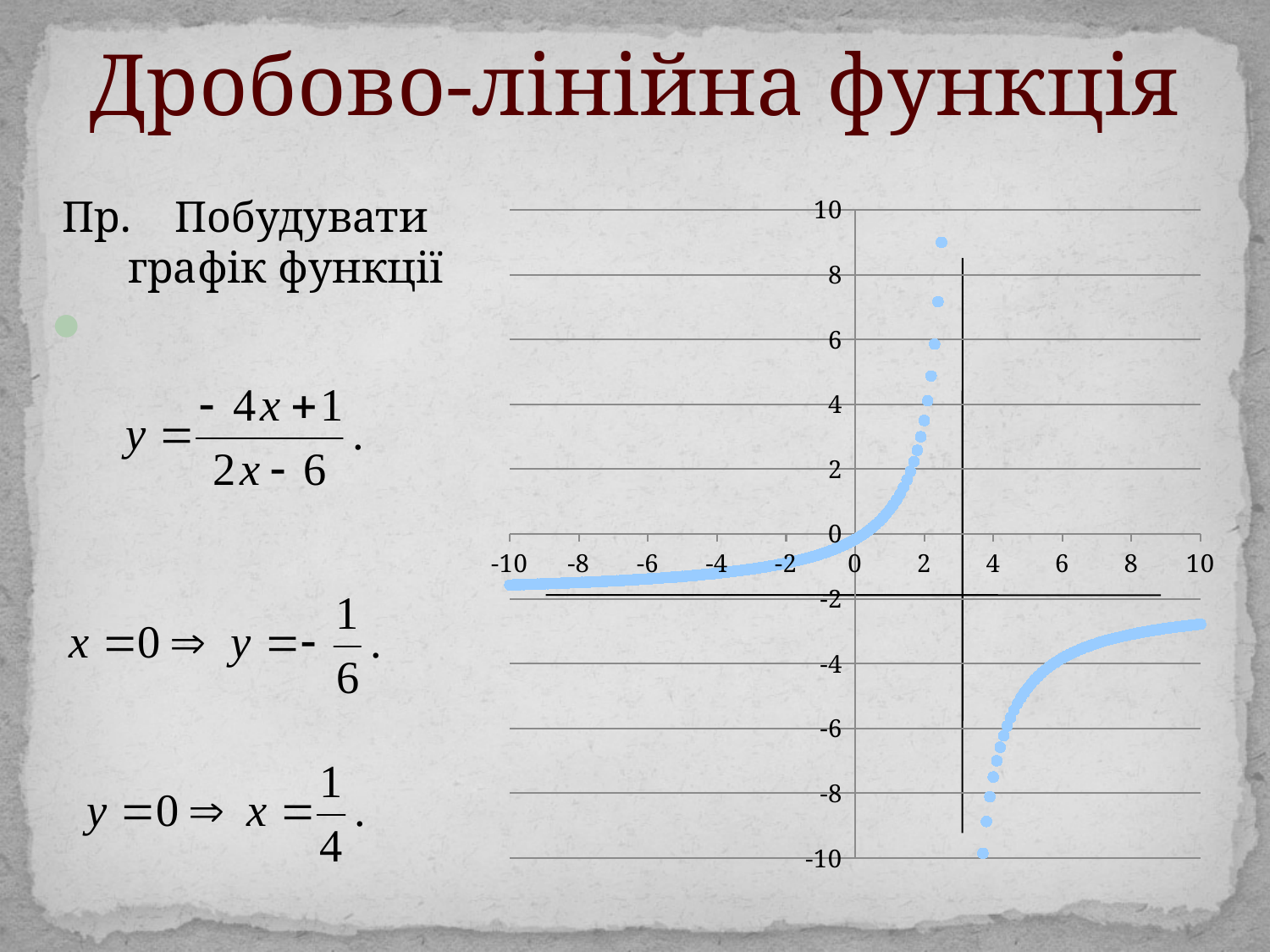
Is the plotted value at x = 10 greater or less than -2? less Is the plotted value at x = -4 greater or less than 0? less What is the range of the x axis on the chart? -10 to 10 What colour are the plotted points on the chart? light blue What kind of chart is shown on the slide? scatter chart Is the plotted value at x = -10 greater or less than -2? greater Do the plotted values rise or fall as x goes from 4 to 10? rise Do the plotted values rise or fall as x goes from -10 to 0? rise Which is larger, the plotted value at x = 2 or the plotted value at x = 4? x = 2